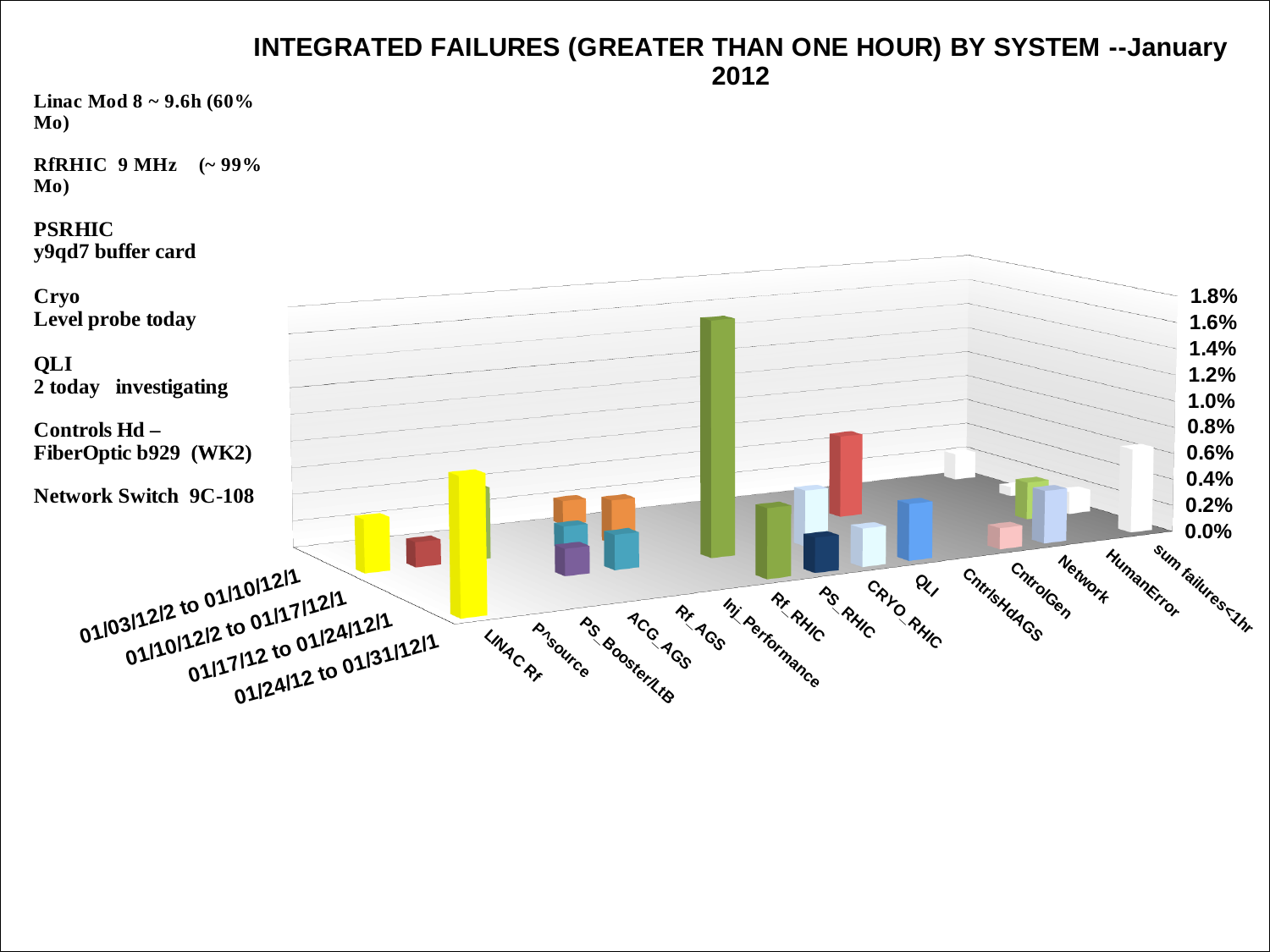
How many system categories are listed along the horizontal axis of the chart? 15 Is the tallest bar for Rf_AGS greater or less than 1.0%? less How many weekly date ranges are shown along the depth axis of the chart? 4 What is the highest value shown on the vertical axis of the chart? 1.8% What is the last category listed on the horizontal axis of the chart? sum failures<1hr What is the first date range listed on the depth axis of the chart? 01/03/12/2 to 01/10/12/1 Which is taller, the tallest bar for Rf_AGS or the tallest bar for LINAC Rf? LINAC Rf What kind of chart is shown on the slide? bar chart Is the tallest bar for PS_RHIC greater or less than 1.0%? less Which system has the tallest bar in the chart? Rf_RHIC